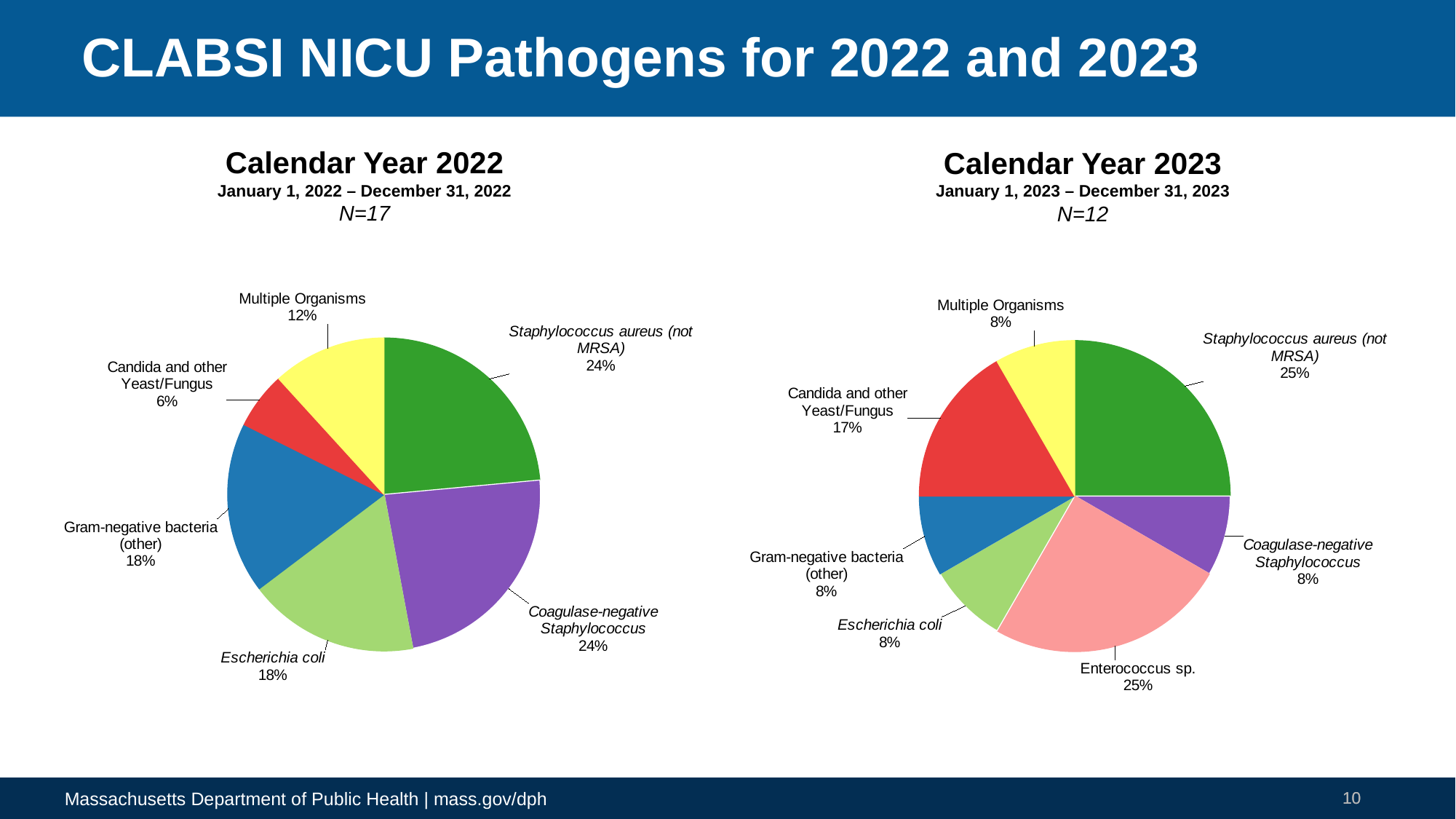
How many categories are shown in the Calendar Year 2023 chart? 7 In the Calendar Year 2023 chart, what is the difference between the Staphylococcus aureus (not MRSA) share and the Escherichia coli share? 17% In the Calendar Year 2022 chart, what share of the pie is Escherichia coli? 18% In the Calendar Year 2023 chart, what share of the pie is Candida and other Yeast/Fungus? 17% In the Calendar Year 2022 chart, what is the value for Multiple Organisms? 12% In the Calendar Year 2023 chart, which category has the largest slice, Candida and other Yeast/Fungus or Multiple Organisms? Candida and other Yeast/Fungus In the Calendar Year 2023 chart, what is the value for Enterococcus sp.? 25% In the Calendar Year 2022 chart, which category has the smallest slice? Candida and other Yeast/Fungus In the Calendar Year 2022 chart, what is the difference between the Coagulase-negative Staphylococcus share and the Gram-negative bacteria (other) share? 6% What kind of chart is the Calendar Year 2023 chart? Pie chart What is the N value stated for the Calendar Year 2022 chart? N=17 How many categories are shown in the Calendar Year 2022 chart? 6